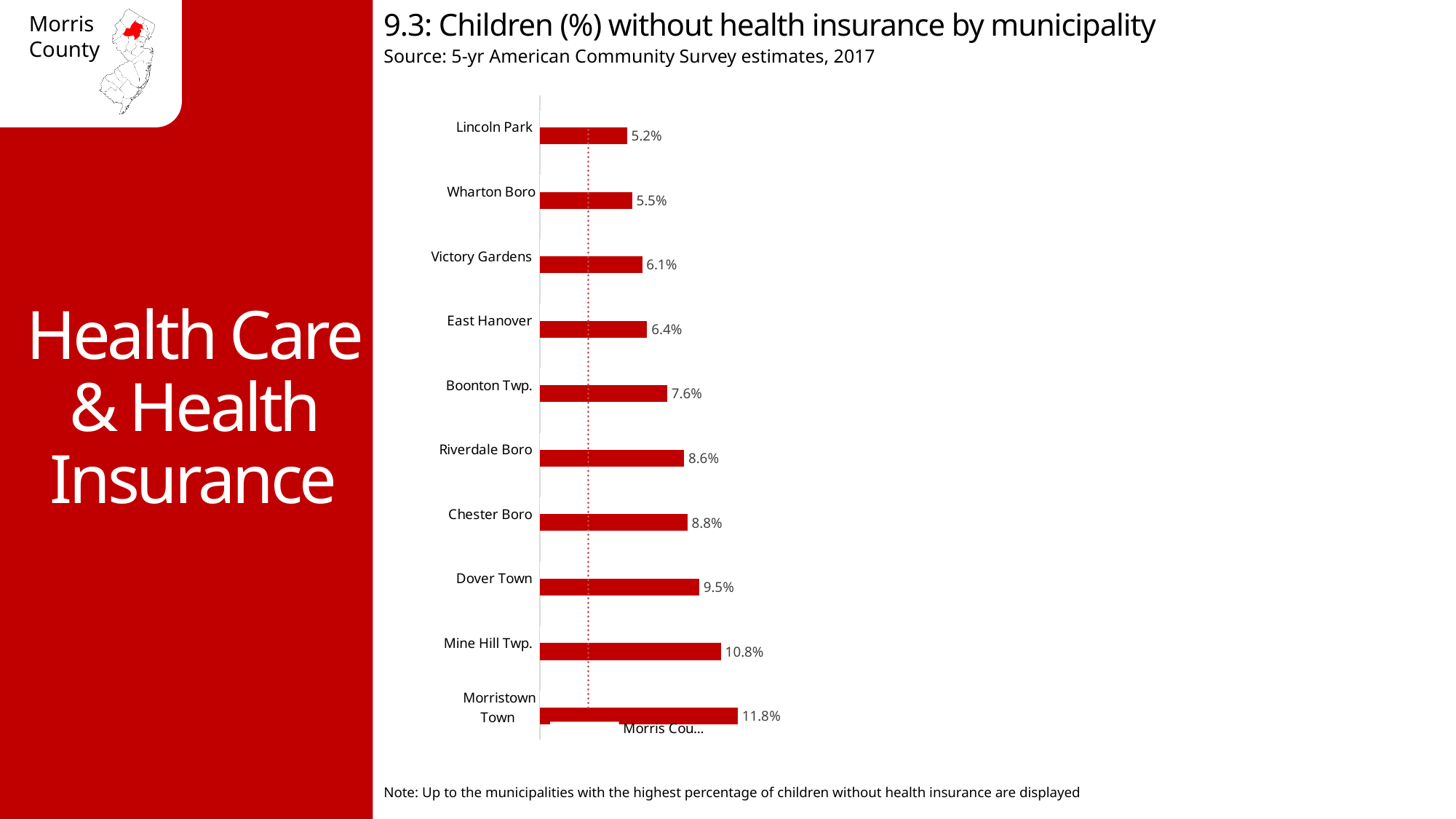
What is the source of the data shown in the chart? 5-yr American Community Survey estimates, 2017 What percentage of children are without health insurance in Dover Town? 9.5% What is the value shown for Victory Gardens? 6.1% What is the difference between the values for Morristown Town and Lincoln Park? 6.6% What kind of chart is shown on the slide? Bar chart Which municipality has the highest percentage of children without health insurance? Morristown Town What is the difference between the values for Chester Boro and Riverdale Boro? 0.2% Which municipality has the lowest percentage of children without health insurance? Lincoln Park What is the title of the chart? 9.3: Children (%) without health insurance by municipality How many municipalities are shown in the chart? 10 Which has a higher percentage of children without health insurance, Boonton Twp. or East Hanover? Boonton Twp. What percentage is shown for Mine Hill Twp.? 10.8%